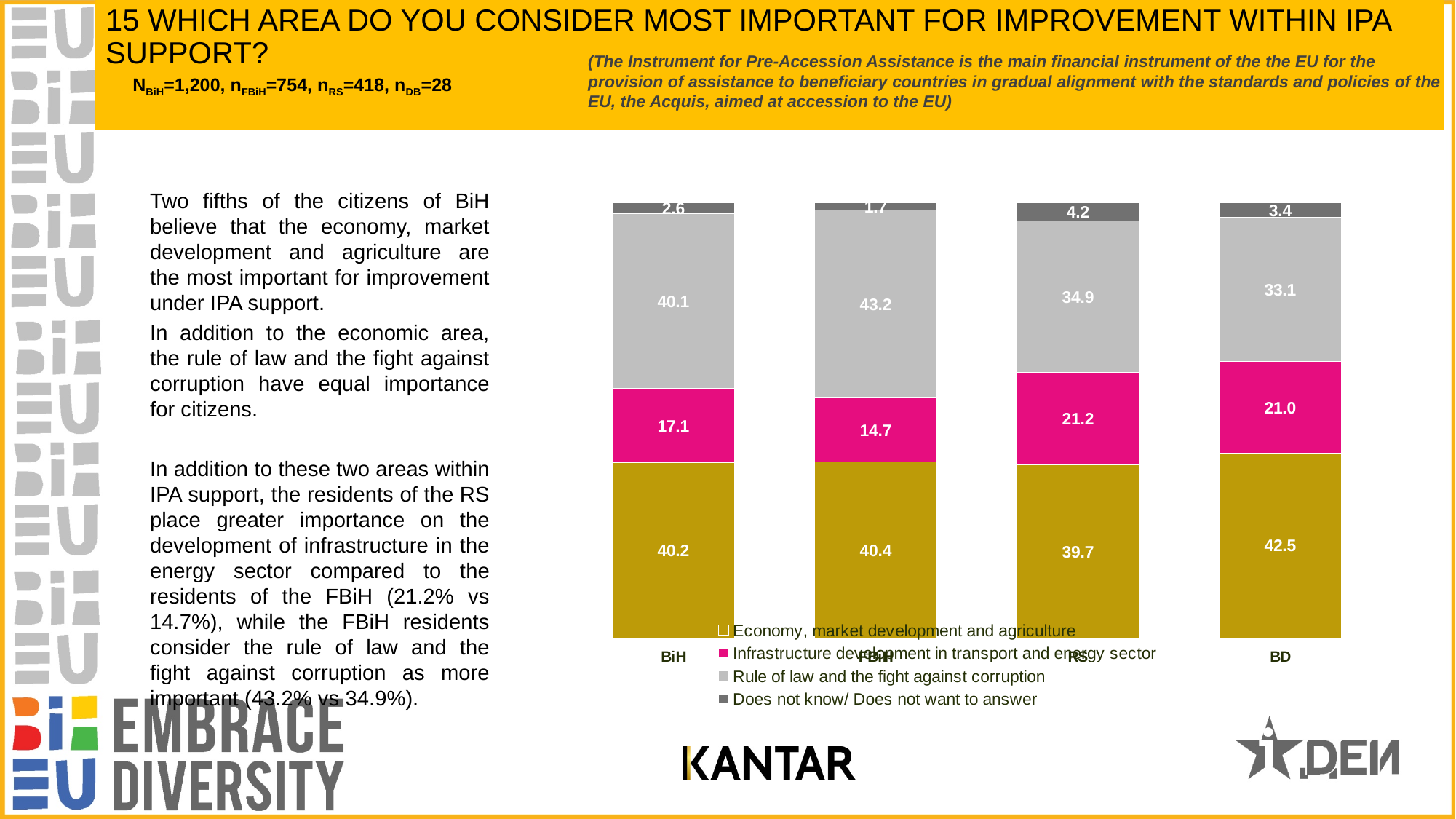
Which category has the lowest value for 'Infrastructure development in transport and energy sector'? FBiH What is the value for 'Does not know/ Does not want to answer' for BiH? 2.6 What is the total of the stacked bar for BD? 100.0 What is the value for 'Rule of law and the fight against corruption' for FBiH? 43.2 Which category has the highest value for 'Rule of law and the fight against corruption'? FBiH What is the difference between the 'Infrastructure development in transport and energy sector' values for RS and FBiH? 6.5 How many categories (bars) are shown on the x axis of the chart? 4 What kind of chart is shown on the slide? stacked bar chart What is the value for 'Economy, market development and agriculture' for BD? 42.5 What is the value for 'Infrastructure development in transport and energy sector' for RS? 21.2 How many series does the chart legend list? 4 Which is larger: the 'Rule of law and the fight against corruption' value for RS or for BD? RS